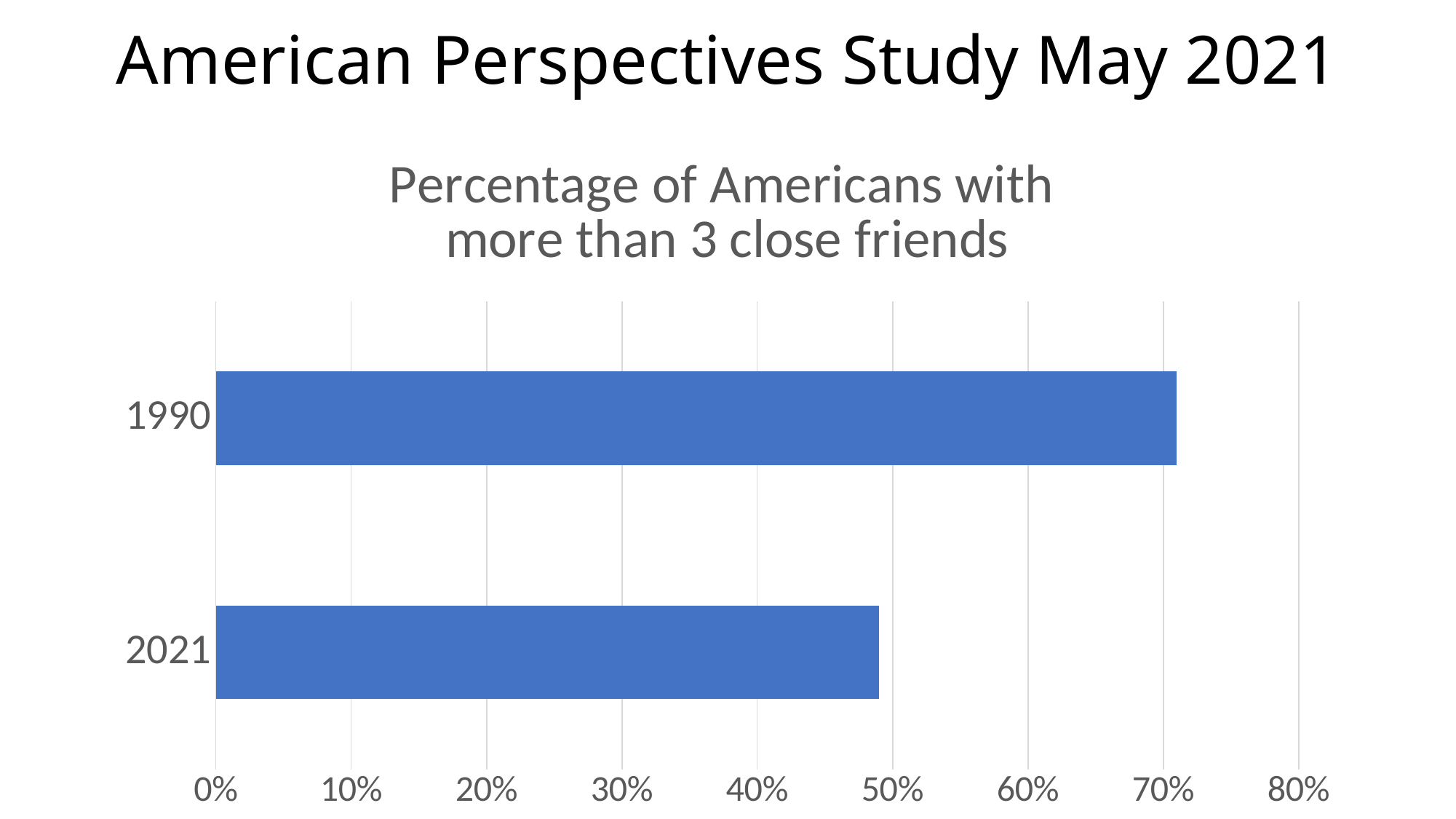
Is the value for 1990 larger or smaller than the value for 2021? larger Is the value for 1990 greater or less than 80%? less Is the value for 2021 greater or less than 40%? greater How many categories are plotted in the chart? 2 Which year has the higher percentage of Americans with more than 3 close friends? 1990 What is the title of the chart? Percentage of Americans with more than 3 close friends Is the value for 2021 greater or less than 60%? less What kind of chart is shown on the slide? bar chart Which year has the lower percentage of Americans with more than 3 close friends? 2021 Did the percentage of Americans with more than 3 close friends rise or fall from 1990 to 2021? fall What is the highest value shown on the horizontal axis? 80%